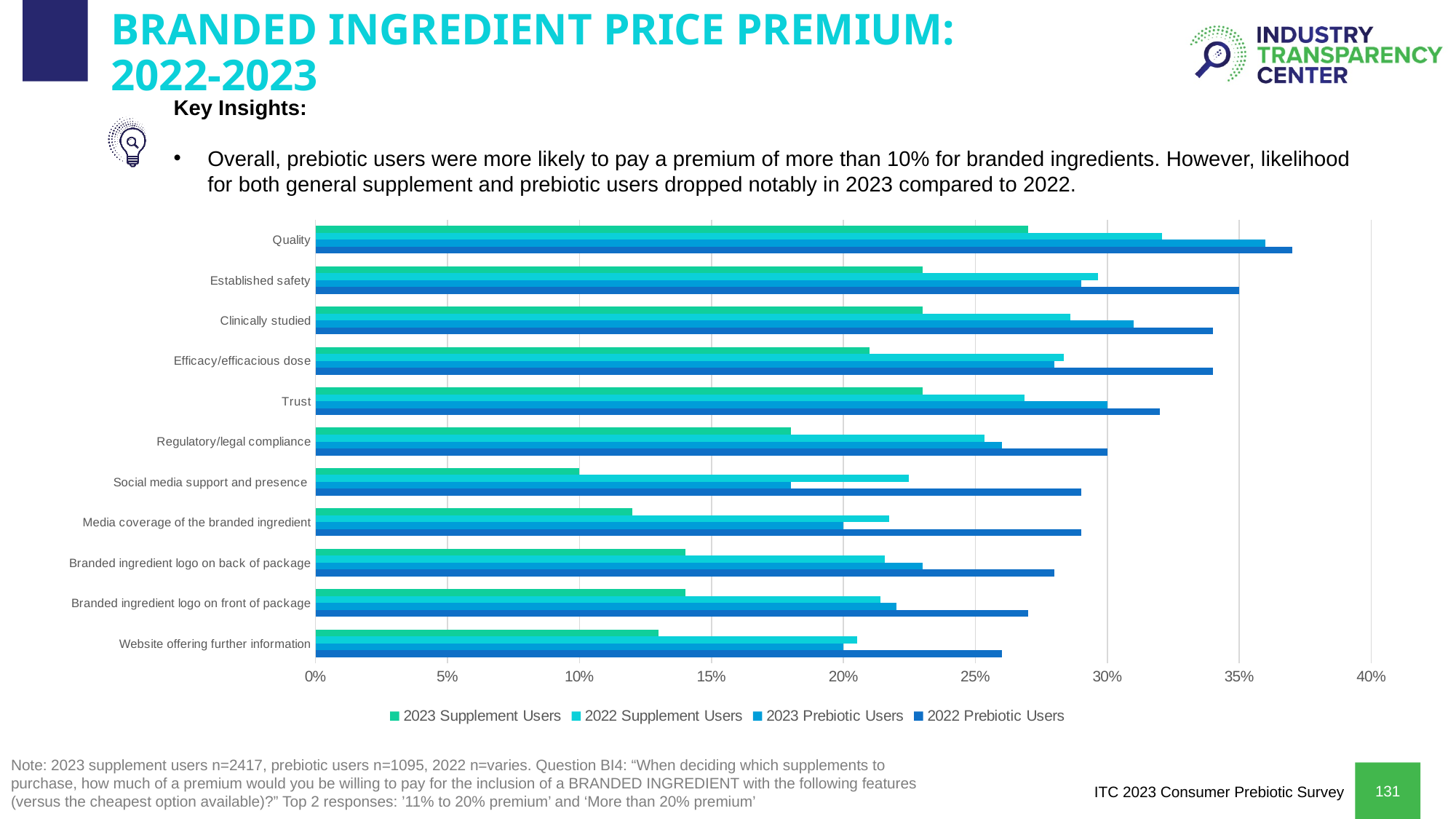
Is the value for 2022 Prebiotic Users on Website offering further information greater or less than 30%? less What kind of chart is shown on the slide? Bar chart Is the value for 2022 Prebiotic Users on Quality greater or less than 35%? greater How many series does the chart legend list? 4 Which category has the highest value for 2022 Prebiotic Users? Quality For 2023 Supplement Users, which is larger: the value for Quality or for Media coverage of the branded ingredient? Quality For Social media support and presence, which is larger: the value for 2022 Prebiotic Users or 2023 Prebiotic Users? 2022 Prebiotic Users How many categories (features) are plotted on the chart? 11 Is the value for 2023 Supplement Users on Quality greater or less than 25%? greater Which category has the lowest value for 2023 Supplement Users? Social media support and presence Which series is shown in green in the chart legend? 2023 Supplement Users